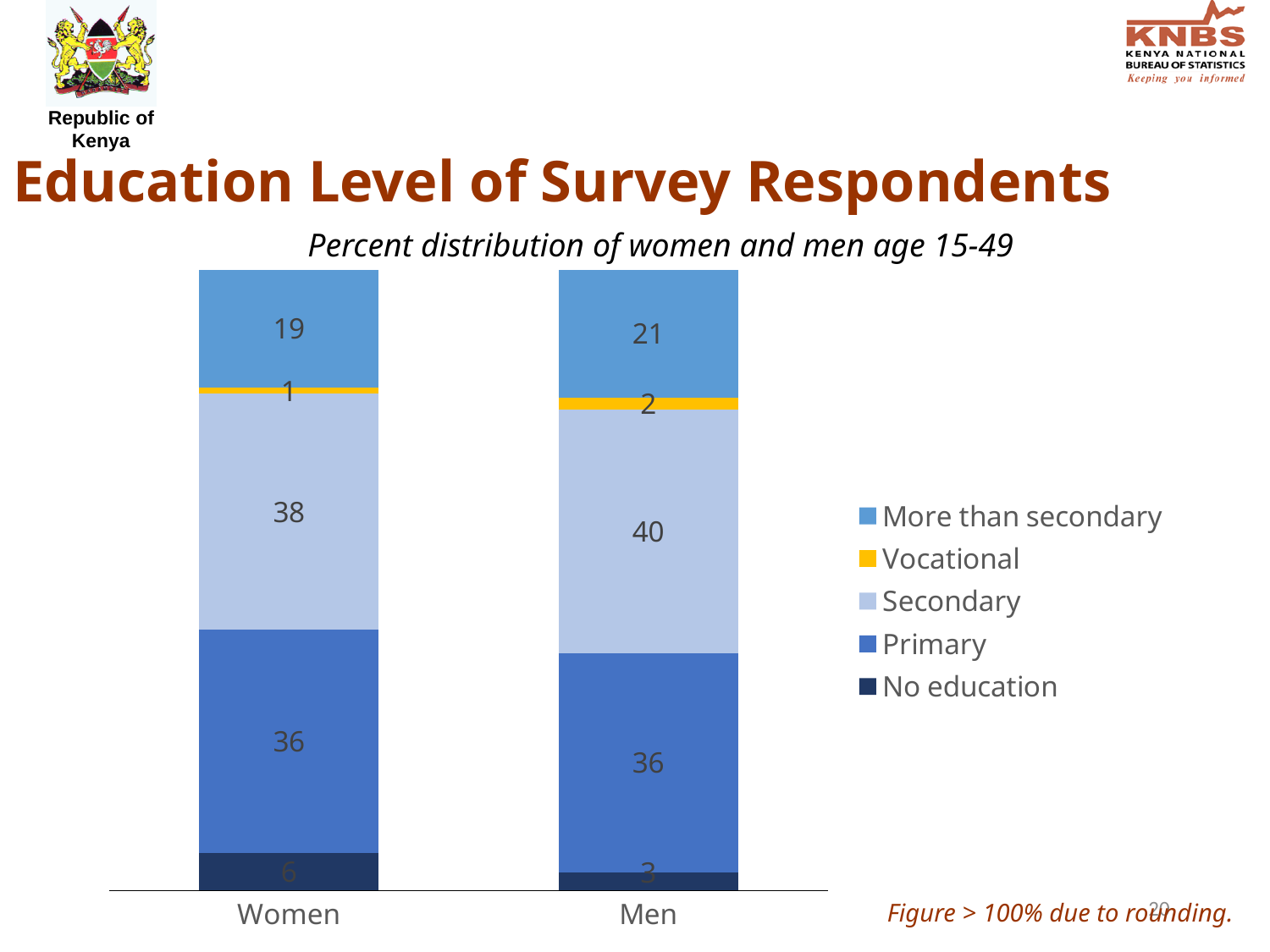
What is the No education value for Women? 6 What is the Secondary value for Women? 38 What is the Vocational value for Men? 2 What kind of chart is shown on the slide? Stacked bar chart How many series does the legend list? 5 Which education level is the smallest segment in the Women bar? Vocational What is the More than secondary value for Men? 21 Which has the larger No education value, Women or Men? Women What is the total of the stacked bar for Men? 102 How many categories are shown on the x axis of the chart? 2 Which education level is the largest segment in the Men bar? Secondary What is the difference between the Secondary values for Men and Women? 2